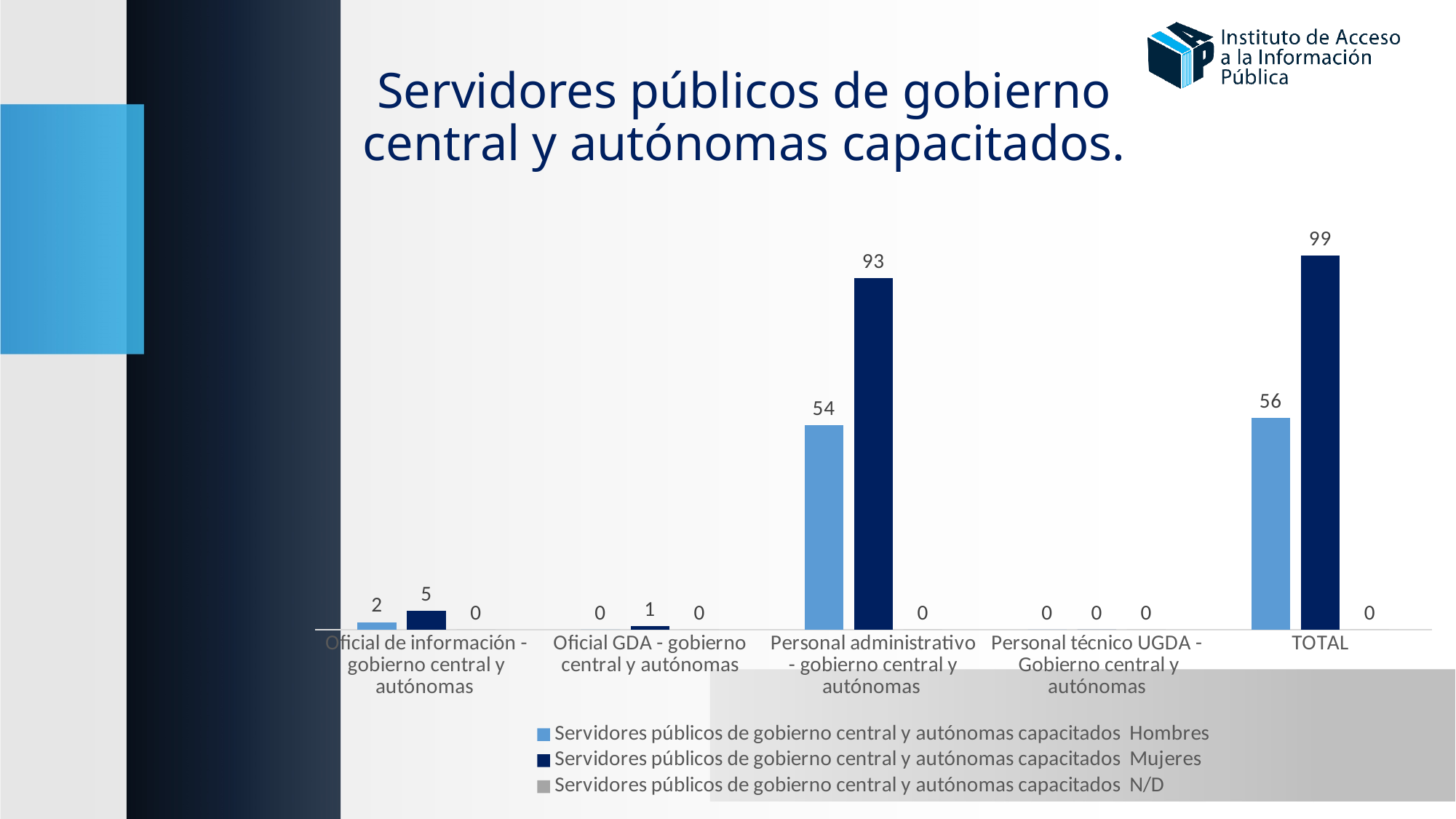
What is the difference between the Mujeres and Hombres values in the TOTAL category? 43 How many series does the legend list? 3 What is the difference between Mujeres and Hombres in the Personal administrativo - gobierno central y autónomas category? 39 What is the value for Hombres in the Oficial GDA - gobierno central y autónomas category? 0 How many categories are shown on the x axis? 5 What is the value for N/D in the Personal técnico UGDA - Gobierno central y autónomas category? 0 What is the value for Mujeres in the Oficial de información - gobierno central y autónomas category? 5 Which category has the highest Mujeres value? TOTAL What is the value for Mujeres in the Personal administrativo - gobierno central y autónomas category? 93 What kind of chart is shown on the slide? Bar chart What is the value for Hombres in the TOTAL category? 56 In the Oficial de información - gobierno central y autónomas category, which is larger, Hombres or Mujeres? Mujeres